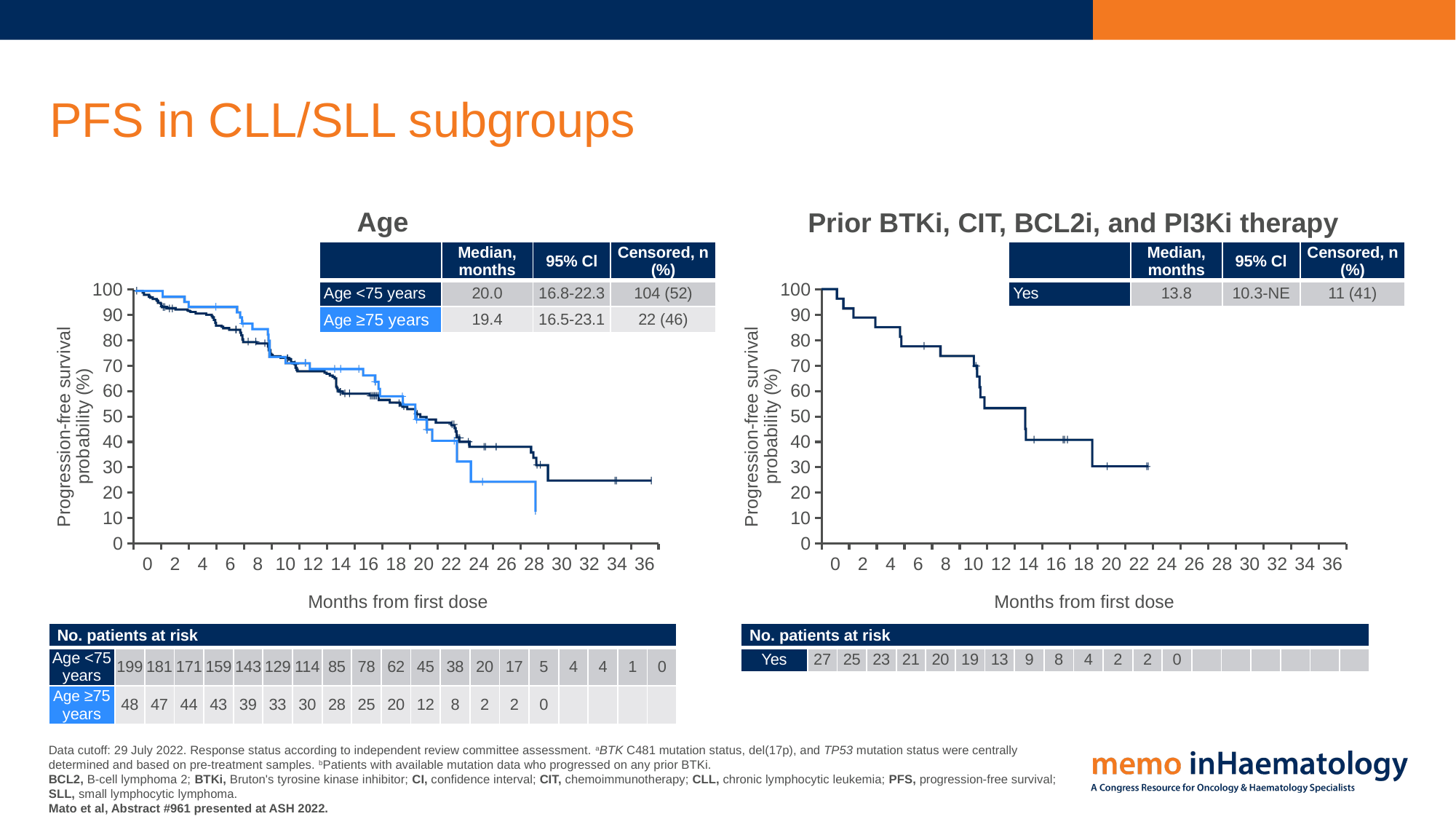
How many series are plotted in the Age chart? 2 In the Prior BTKi, CIT, BCL2i, and PI3Ki therapy chart, is the progression-free survival probability at month 20 greater or less than 40? less In the Age chart, what is the median PFS in months for Age ≥75 years? 19.4 In the Prior BTKi, CIT, BCL2i, and PI3Ki therapy chart, what is the median PFS in months? 13.8 In the Age chart, what is the difference in median PFS months between Age <75 years and Age ≥75 years? 0.6 In the Age chart, which group has the higher median PFS, Age <75 years or Age ≥75 years? Age <75 years In the Age chart, what is the 95% CI for Age ≥75 years? 16.5-23.1 In the Age chart, what is the median PFS in months for Age <75 years? 20.0 In the Prior BTKi, CIT, BCL2i, and PI3Ki therapy chart, what is the 95% CI? 10.3-NE In the Prior BTKi, CIT, BCL2i, and PI3Ki therapy chart, how many patients were at risk at month 12? 13 In the Age chart, how many patients aged <75 years were at risk at month 0? 199 In the Age chart, what is the censored n (%) for Age <75 years? 104 (52)